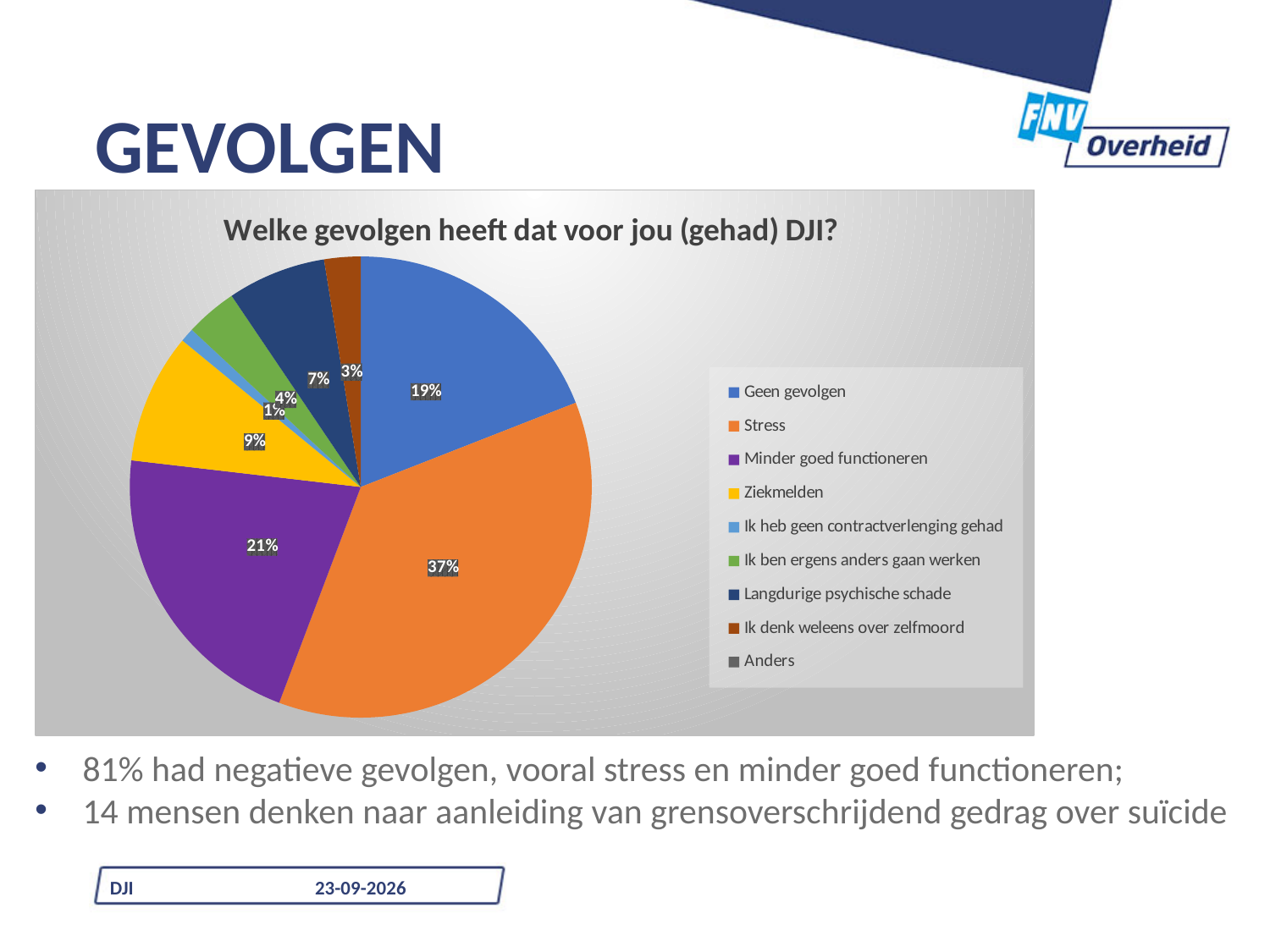
Which category has the largest slice of the pie? Stress Which is larger, the slice for Geen gevolgen or the slice for Minder goed functioneren? Minder goed functioneren What is the title of the chart? Welke gevolgen heeft dat voor jou (gehad) DJI? What kind of chart is shown on the slide? pie chart What share of the pie does Langdurige psychische schade have? 7% How many entries does the legend list? 9 What share of the pie does Minder goed functioneren have? 21% What share of the pie does Ik denk weleens over zelfmoord have? 3% What is the difference in percentage points between the Stress slice and the Minder goed functioneren slice? 16